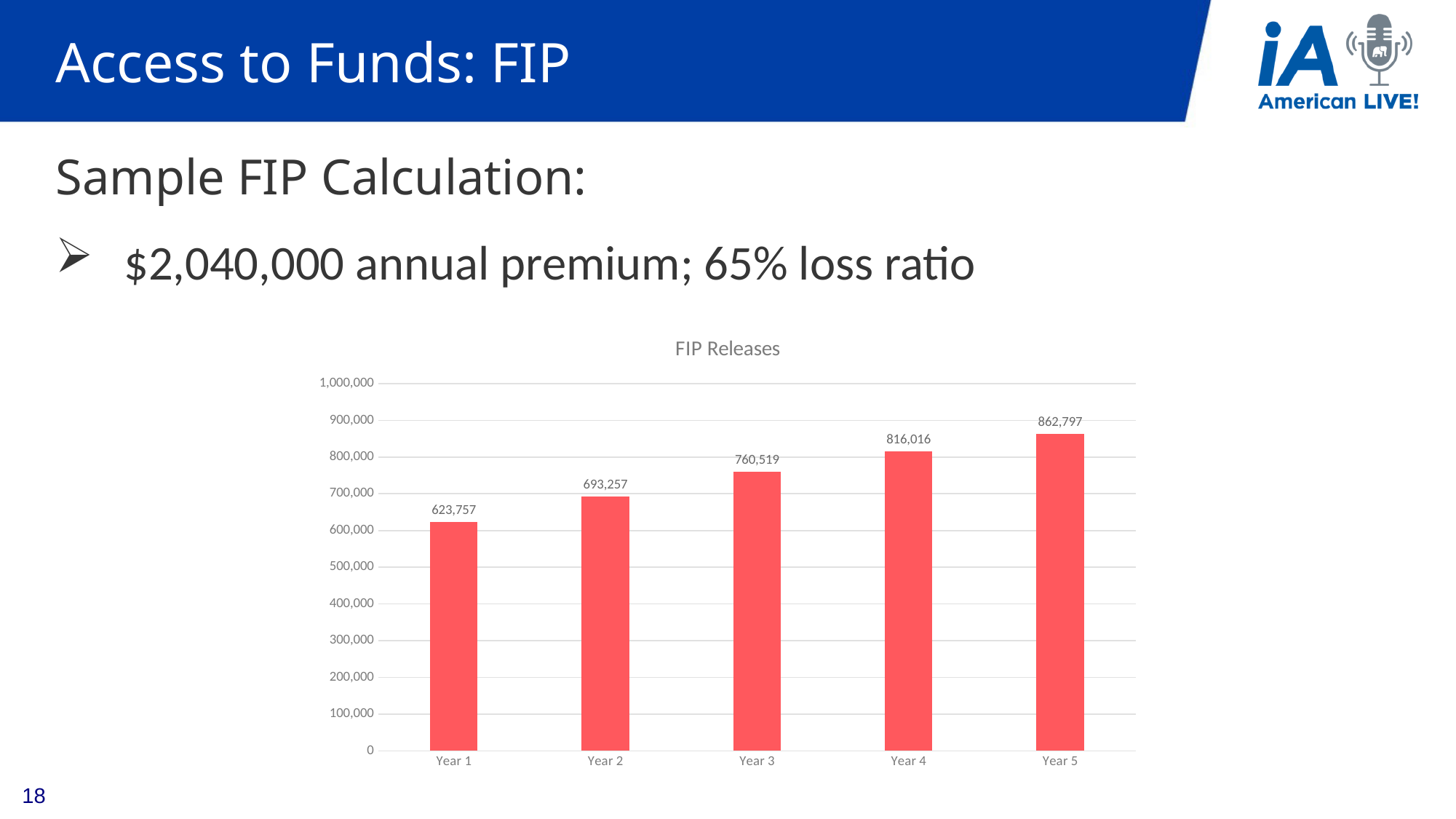
Is the FIP release for Year 4 greater or less than 800,000? greater Do the FIP release values rise or fall from Year 1 to Year 5? rise What is the difference between the FIP release in Year 5 and Year 1? 239,040 Which is larger, the FIP release in Year 4 or Year 2? Year 4 How many years are shown on the x axis of the chart? 5 Which year has the lowest FIP release? Year 1 What is the FIP release value for Year 3? 760,519 What is the difference between the FIP release in Year 2 and Year 1? 69,500 Which year has the highest FIP release? Year 5 What is the FIP release value for Year 1? 623,757 What is the FIP release value for Year 5? 862,797 What kind of chart is used to show FIP Releases? bar chart